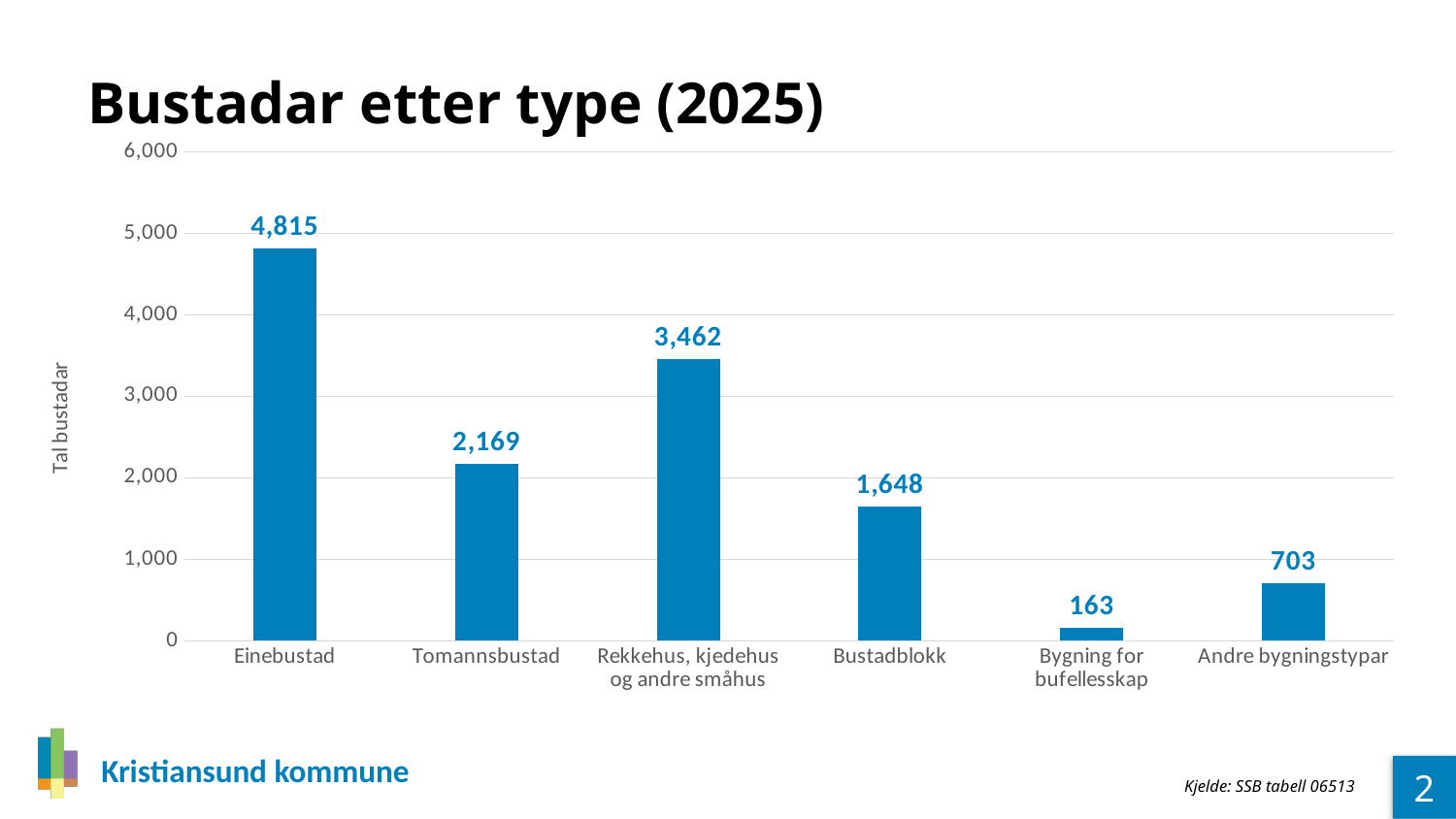
What kind of chart is shown on the slide? Bar chart What is the value for Bygning for bufellesskap? 163 What is the value for Einebustad? 4,815 What is the difference between the values for Tomannsbustad and Bustadblokk? 521 What is the title of the chart? Bustadar etter type (2025) How many categories are shown on the x axis? 6 What is the difference between the values for Einebustad and Rekkehus, kjedehus og andre småhus? 1,353 What is the value for Andre bygningstypar? 703 Which category has the lowest value? Bygning for bufellesskap Which category has the highest value? Einebustad What is the value for Tomannsbustad? 2,169 Which is larger, the value for Bustadblokk or the value for Andre bygningstypar? Bustadblokk